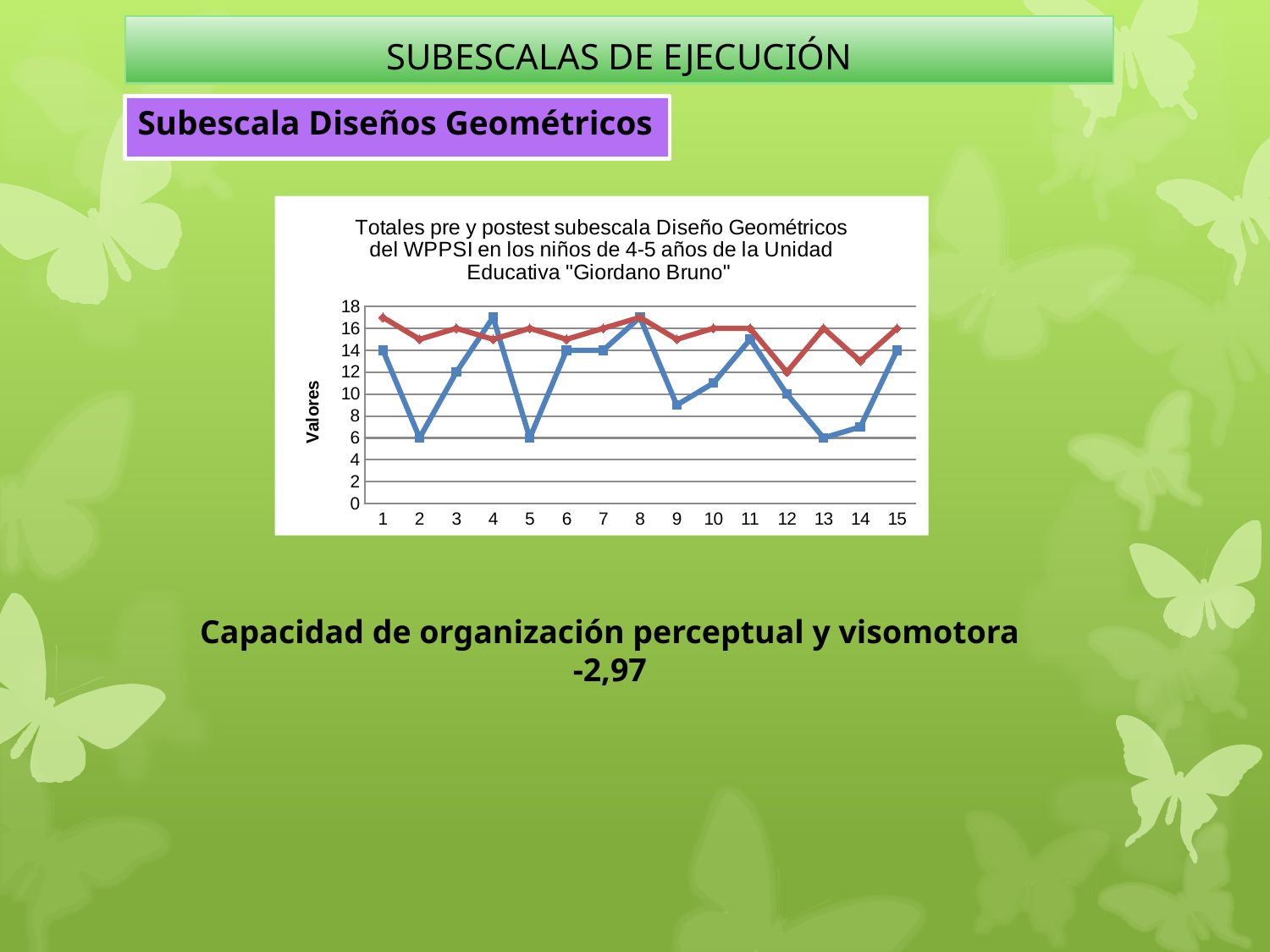
What is the value of the blue line at point 3? 12 At point 2, which line has the higher value, the red line or the blue line? red line What is the label of the vertical axis of the chart? Valores What is the value of the red line at point 3? 16 What is the difference between the red line and the blue line at point 3? 4 Is the value of the blue line at point 13 greater or less than 8? less At which point does the red line reach its lowest value? 12 How many lines are plotted in the chart? 2 What is the value of the blue line at point 2? 6 What kind of chart is shown on the slide? line chart What is the value of the red line at point 12? 12 How many points are plotted along the x axis of the chart? 15